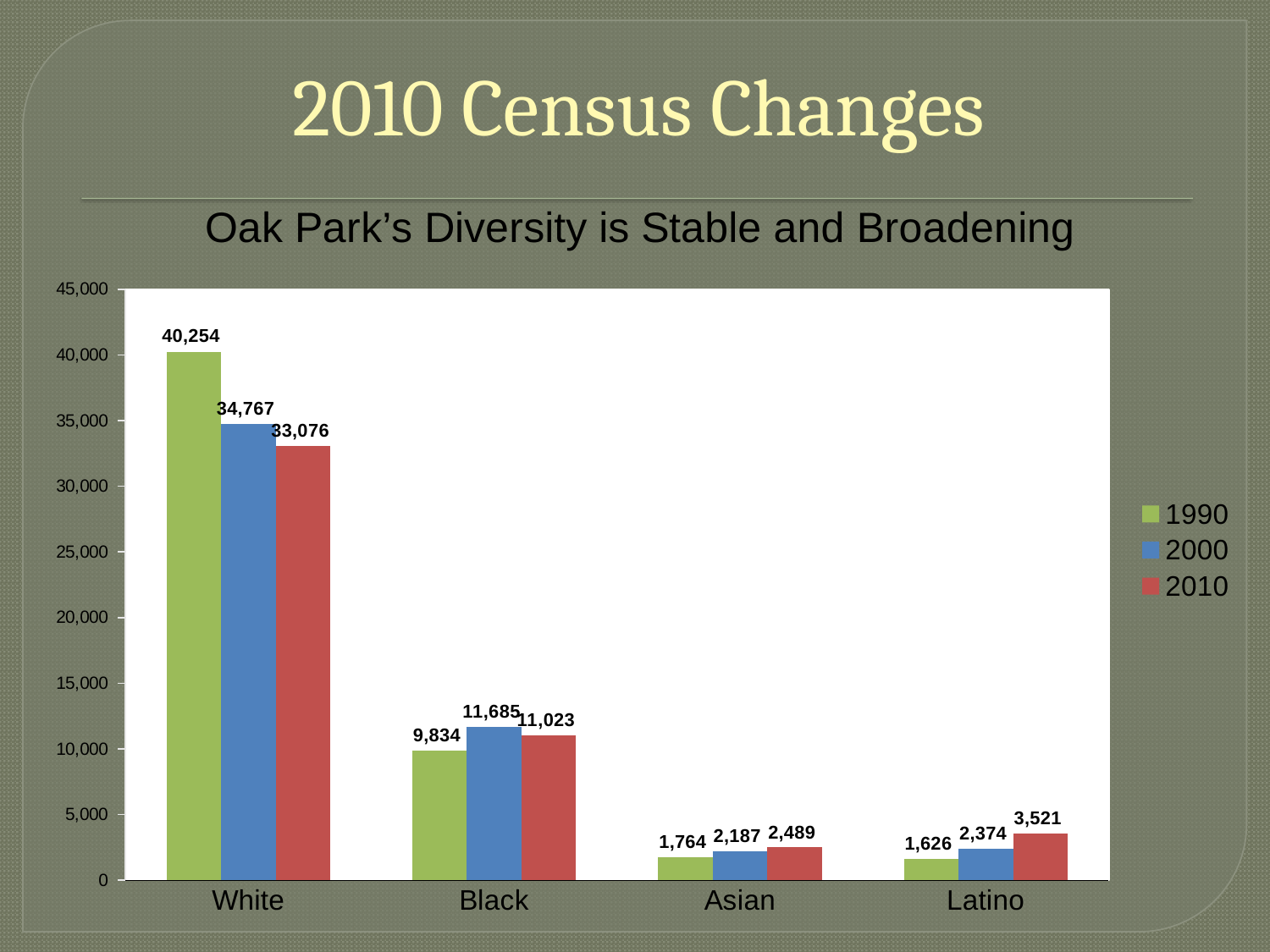
What was the White population in 1990? 40,254 How many series does the legend list? 3 Which category has the highest value in 2010? White What is the difference between the White population in 1990 and in 2010? 7,178 What was the Black population in 2000? 11,685 What kind of chart is shown on the slide? Bar chart Which is larger, the Asian population in 2010 or the Latino population in 2010? Latino population in 2010 Does the Latino population rise or fall from 1990 to 2010? Rise What was the Latino population in 2010? 3,521 Which category has the lowest value in 1990? Latino What was the Asian population in 1990? 1,764 How many categories are shown on the x axis? 4